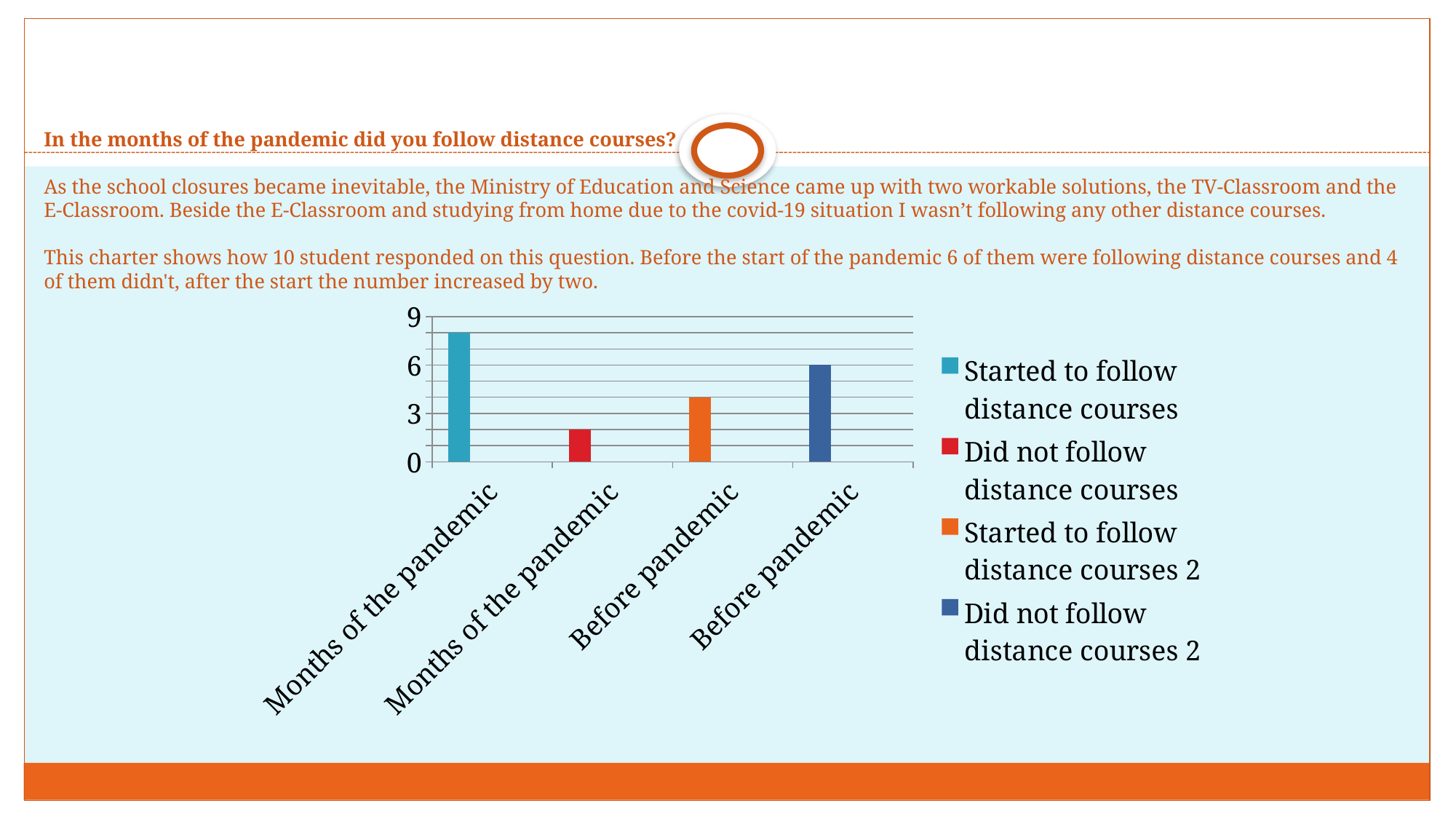
Is the value for 'Started to follow distance courses' (Months of the pandemic) greater or less than 6? greater Which is larger: the 'Started to follow distance courses' bar or the 'Did not follow distance courses 2' bar? Started to follow distance courses Which series has the shortest bar in the chart? Did not follow distance courses Which is larger: the 'Started to follow distance courses 2' bar or the 'Did not follow distance courses' bar? Started to follow distance courses 2 Which series has the tallest bar in the chart? Started to follow distance courses How many series does the chart legend list? 4 How many bars are plotted in the chart? 4 Is the value for 'Did not follow distance courses' (Months of the pandemic) greater or less than 3? less What is the value of the 'Did not follow distance courses 2' bar (Before pandemic)? 6 Is the value for 'Started to follow distance courses 2' (Before pandemic) greater or less than 3? greater What colour is the bar for 'Did not follow distance courses' in the chart? red What kind of chart is shown on the slide? bar chart